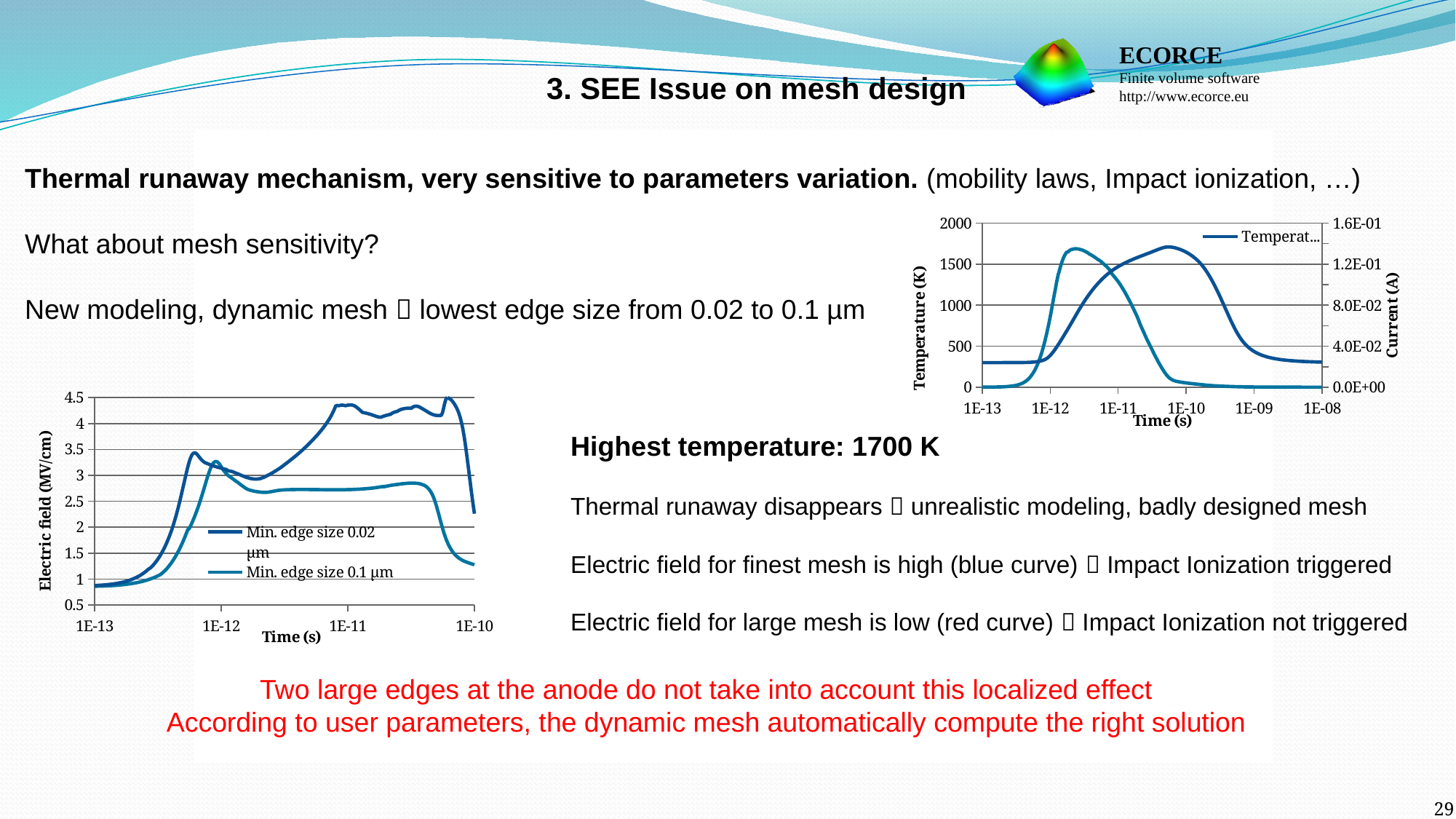
What kind of chart is the top-right chart showing temperature and current versus time? line chart In the bottom-left electric field chart, what are the two legend entries? Min. edge size 0.02 µm; Min. edge size 0.1 µm How many series does the legend of the bottom-left electric field chart list? 2 What is the highest tick value on the y axis of the bottom-left electric field chart? 4.5 In the bottom-left electric field chart, is the value for Min. edge size 0.02 µm at time 1E-11 greater or less than 4? greater In the bottom-left electric field chart, is the value for Min. edge size 0.1 µm at time 1E-11 greater or less than 3? less In the top-right temperature chart, is the temperature at time 1E-08 greater or less than 500? less What kind of chart is the bottom-left chart showing electric field versus time? line chart In the bottom-left electric field chart, which series reaches the higher peak electric field? Min. edge size 0.02 µm